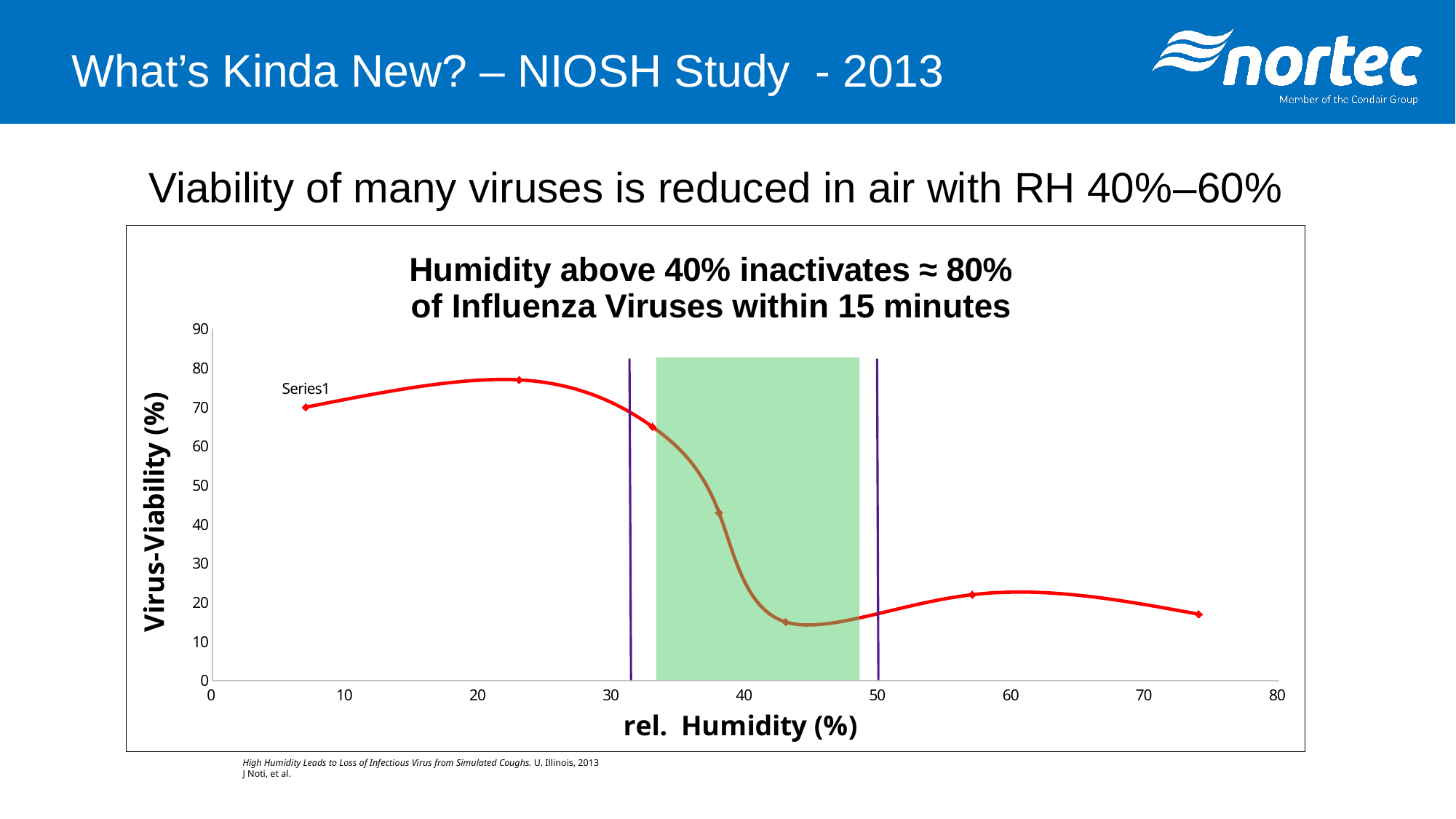
What is the label of the y axis of the chart? Virus-Viability (%) What kind of chart is shown on the slide? line chart Which has the higher virus viability: the data point near 7% relative humidity or the data point near 57% relative humidity? the point near 7% relative humidity Is the virus viability at the first data point (around 7% relative humidity) greater or less than 60? greater How many data points are plotted on the line? 7 Is the virus viability at the data point near 23% relative humidity greater or less than 70? greater Is the virus viability at the last data point (around 74% relative humidity) greater or less than 30? less Does virus viability rise or fall as relative humidity increases from 20% to 45%? fall What is the title of the chart? Humidity above 40% inactivates ≈ 80% of Influenza Viruses within 15 minutes